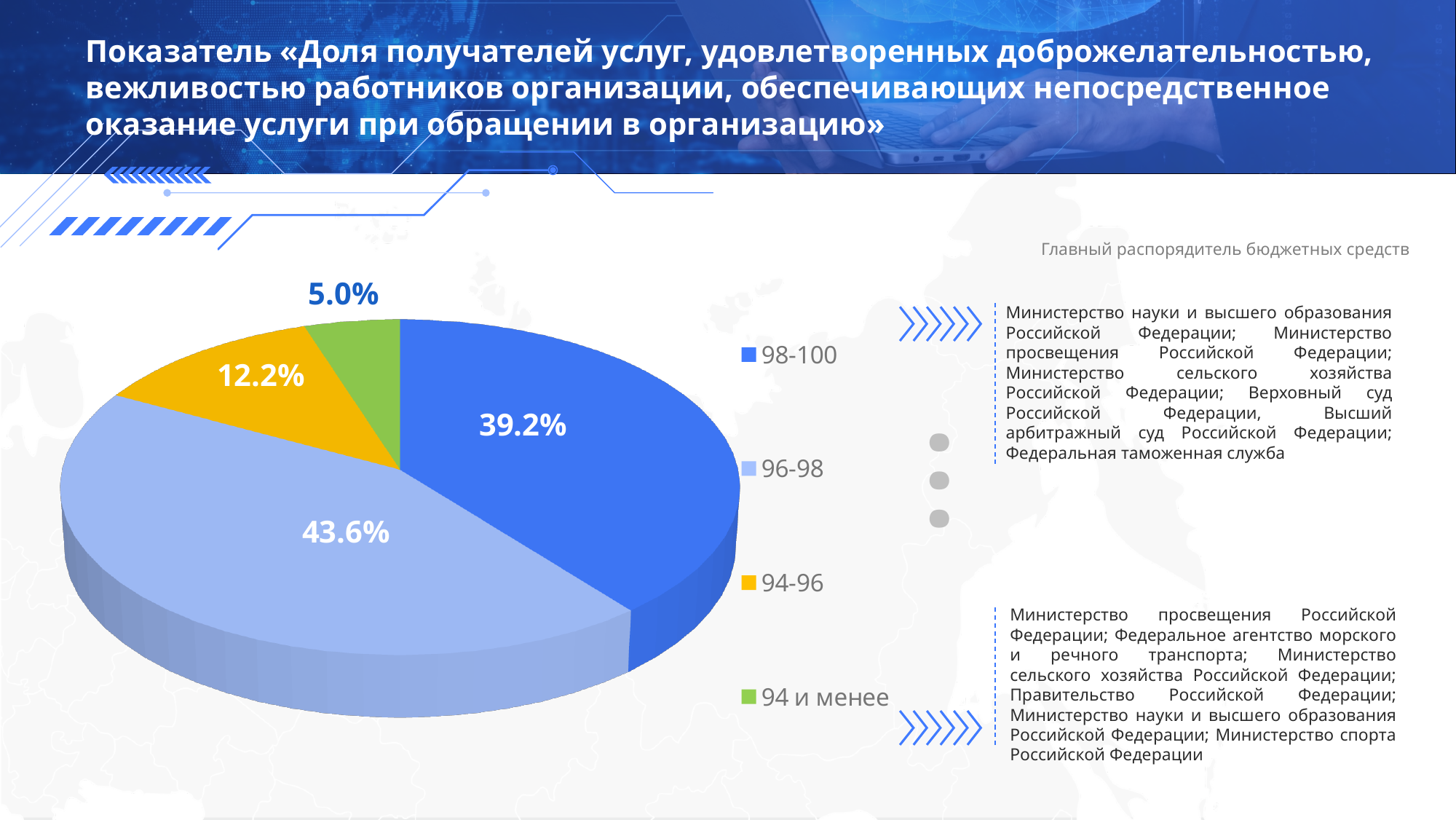
What is the value for the "94-96" slice? 12.2% Which category has the smallest share of the pie? 94 и менее How many entries does the legend list? 4 What is the value for the "96-98" slice? 43.6% What is the difference between the "96-98" and "98-100" slices? 4.4% What is the value for the "98-100" slice? 39.2% What is the value for the "94 и менее" slice? 5.0% Which is larger, the "94-96" slice or the "94 и менее" slice? 94-96 How many slices does the pie chart have? 4 What colour is the "94-96" slice? yellow What kind of chart is shown on the slide? pie chart Which category has the largest share of the pie? 96-98